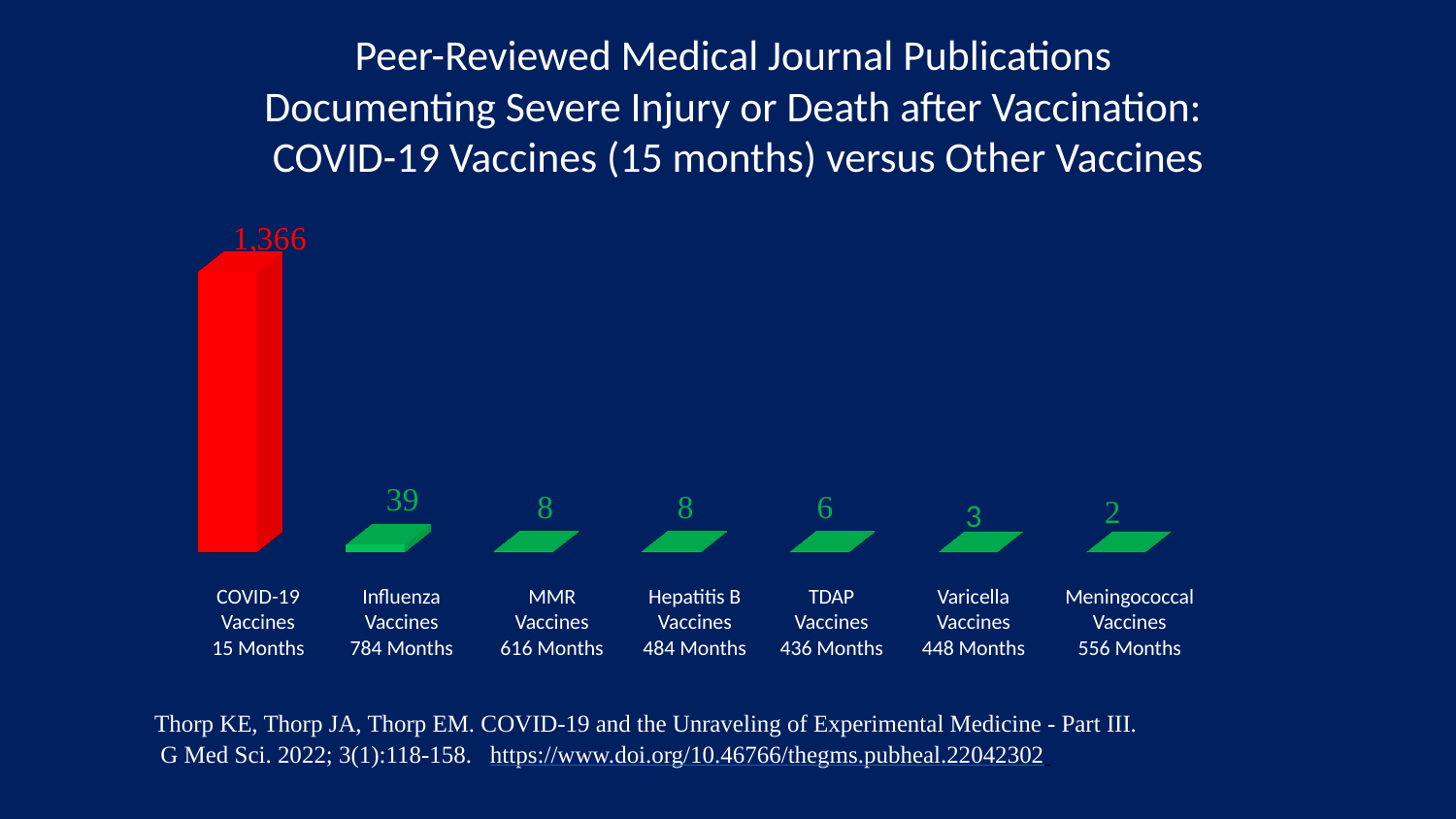
What colour is the bar for COVID-19 Vaccines? Red What kind of chart is shown on the slide? Bar chart Which category has the highest value? COVID-19 Vaccines 15 Months How many categories are shown in the chart? 7 Which category has the lowest value? Meningococcal Vaccines 556 Months What is the value shown for Influenza Vaccines (784 Months)? 39 Which is larger, the value for TDAP Vaccines or the value for Varicella Vaccines? TDAP Vaccines What is the difference between the values for Influenza Vaccines and MMR Vaccines? 31 What is the difference between the values for COVID-19 Vaccines and Influenza Vaccines? 1,327 What is the value shown for TDAP Vaccines (436 Months)? 6 What is the value shown for Meningococcal Vaccines (556 Months)? 2 What is the value shown for COVID-19 Vaccines (15 Months)? 1,366